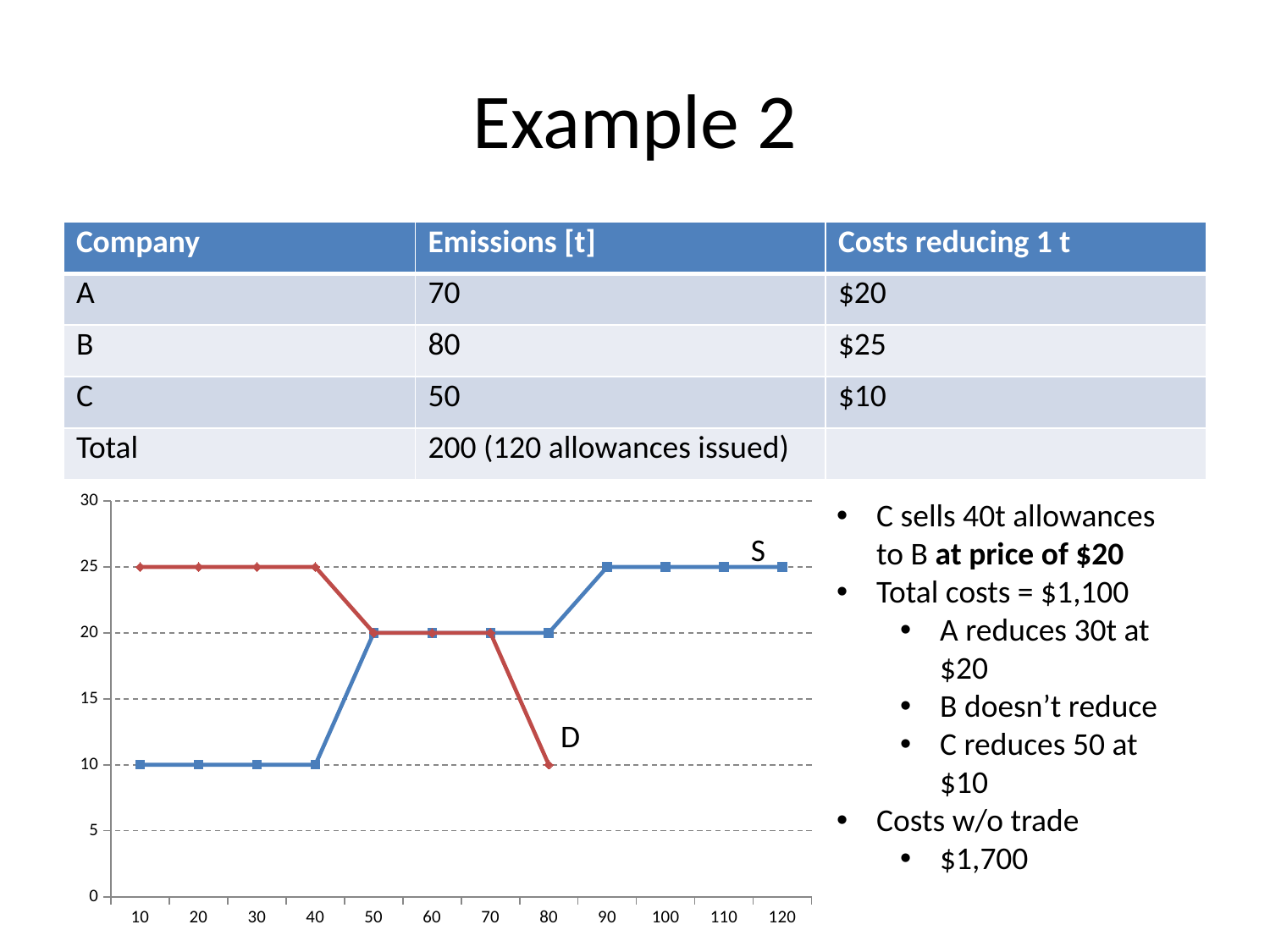
Does the D line rise or fall as x increases from 10 to 80? fall What is the value of the S line at x = 10? 10 What is the value of the D line at x = 80? 10 What is the value of the S line at x = 120? 25 At x = 20, which line is higher, S or D? D Does the S line rise or fall as x increases from 10 to 120? rise How many lines are plotted on the chart? 2 What kind of chart is shown on the slide? line chart What is the difference between the D line and the S line at x = 30? 15 What is the value of the S line at x = 60? 20 At x = 100, is the S line greater or less than 20? greater What is the value of the D line at x = 10? 25